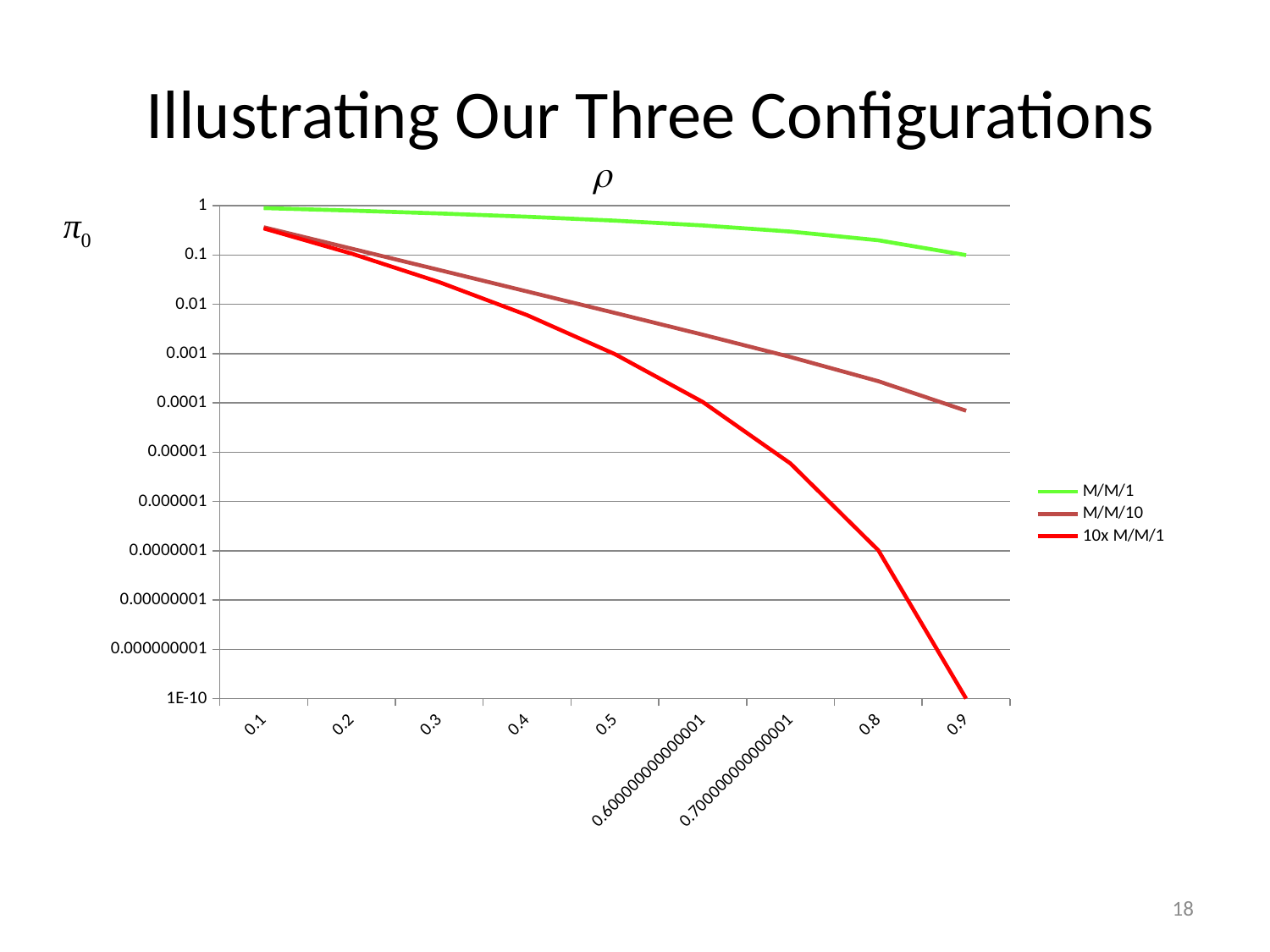
What kind of chart is shown on the slide? line chart At x = 0.5, which series has the larger value, M/M/10 or 10x M/M/1? M/M/10 What is the title of the slide? Illustrating Our Three Configurations Which series has the highest value at x = 0.9? M/M/1 Which series has the lowest value at x = 0.9? 10x M/M/1 Is the value of the M/M/1 series at x = 0.5 greater or less than 0.1? greater Do the values of the series rise or fall as x increases from 0.1 to 0.9? fall Is the value of the 10x M/M/1 series at x = 0.8 greater or less than 0.000001? less How many series does the legend list? 3 How many x-axis points are plotted for each series? 9 What is the value of the 10x M/M/1 series at x = 0.9? 1E-10 What is the value of the M/M/1 series at x = 0.9? 0.1